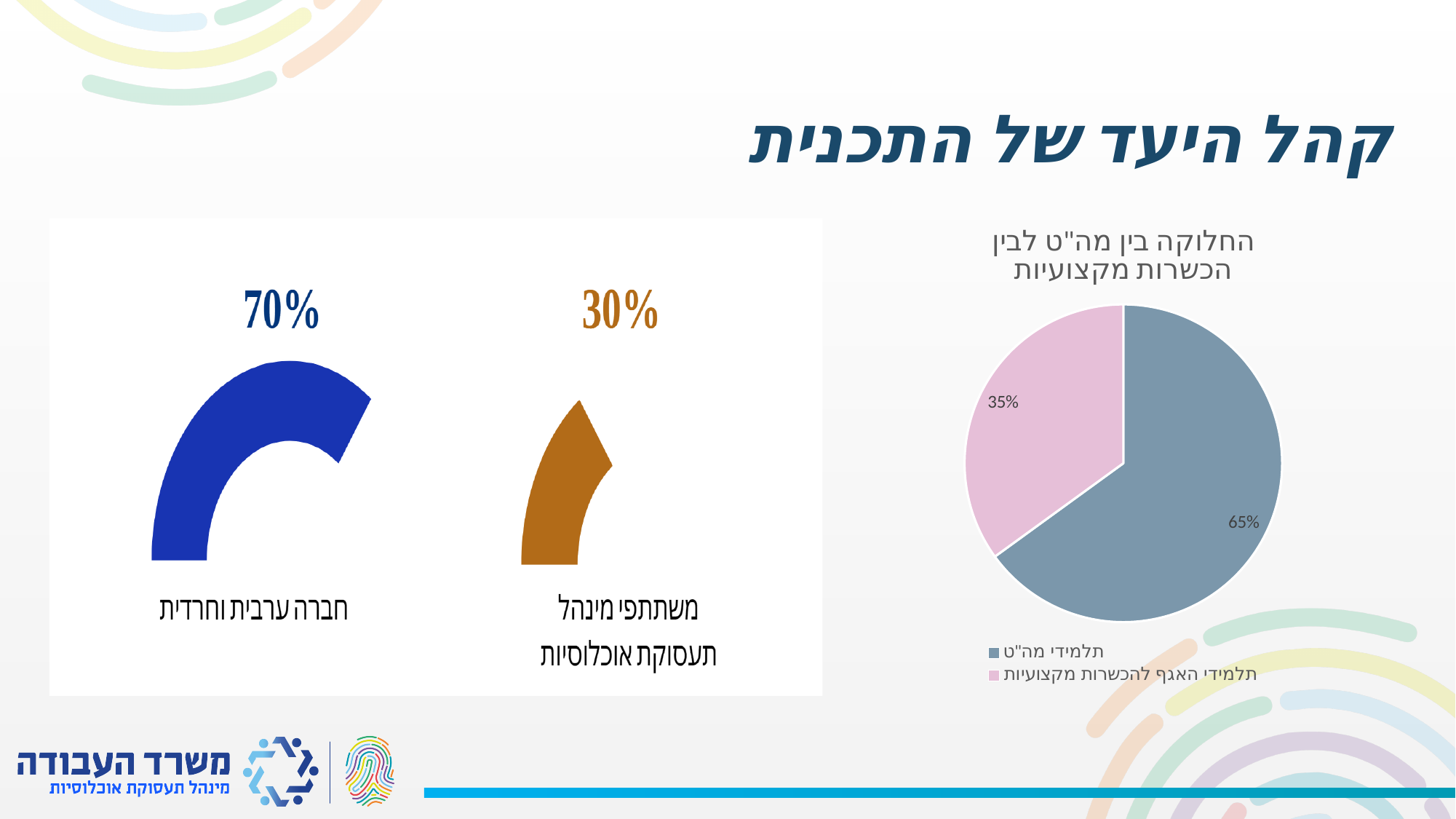
What type of chart is shown on the right side of the slide? Pie chart In the pie chart on the right, which category has the largest slice? תלמידי מה"ט In the pie chart on the right, what is the difference in percentage points between the תלמידי מה"ט slice and the תלמידי האגף להכשרות מקצועיות slice? 30 In the pie chart on the right, which category has the smallest slice? תלמידי האגף להכשרות מקצועיות In the pie chart on the right, what share is shown for תלמידי מה"ט? 65% In the pie chart on the right, which is larger: the slice for תלמידי מה"ט or the slice for תלמידי האגף להכשרות מקצועיות? תלמידי מה"ט How many entries does the legend of the pie chart on the right list? 2 What is the title of the pie chart on the right? החלוקה בין מה"ט לבין הכשרות מקצועיות In the pie chart on the right, what colour is the slice for תלמידי האגף להכשרות מקצועיות? Pink In the graphic on the left, what percentage is shown for חברה ערבית וחרדית? 70% How many slices does the pie chart on the right have? 2 In the pie chart on the right, what share is shown for תלמידי האגף להכשרות מקצועיות? 35%